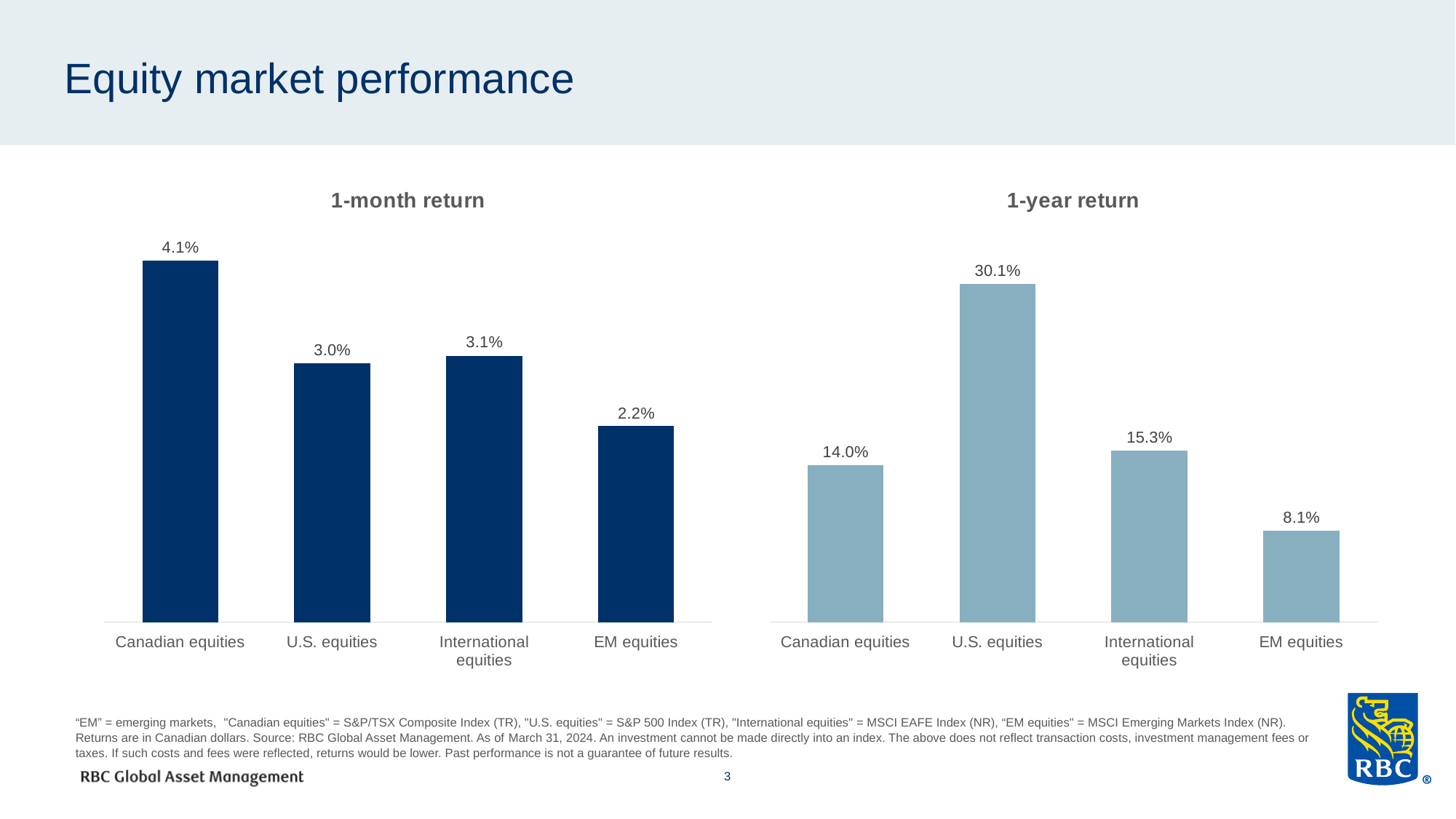
In the '1-year return' chart, what is the value for International equities? 15.3% How many categories are shown in the '1-month return' chart? 4 What kind of chart is the '1-year return' chart? Bar chart In the '1-month return' chart, what is the value for Canadian equities? 4.1% In the '1-month return' chart, what is the difference between Canadian equities and EM equities? 1.9% In the '1-year return' chart, what is the difference between U.S. equities and Canadian equities? 16.1% In the '1-year return' chart, which is larger: International equities or Canadian equities? International equities In the '1-month return' chart, which category has the highest value? Canadian equities In the '1-year return' chart, which category has the lowest value? EM equities In the '1-year return' chart, which category has the highest value? U.S. equities In the '1-year return' chart, what is the value for EM equities? 8.1% In the '1-month return' chart, which category has the lowest value? EM equities